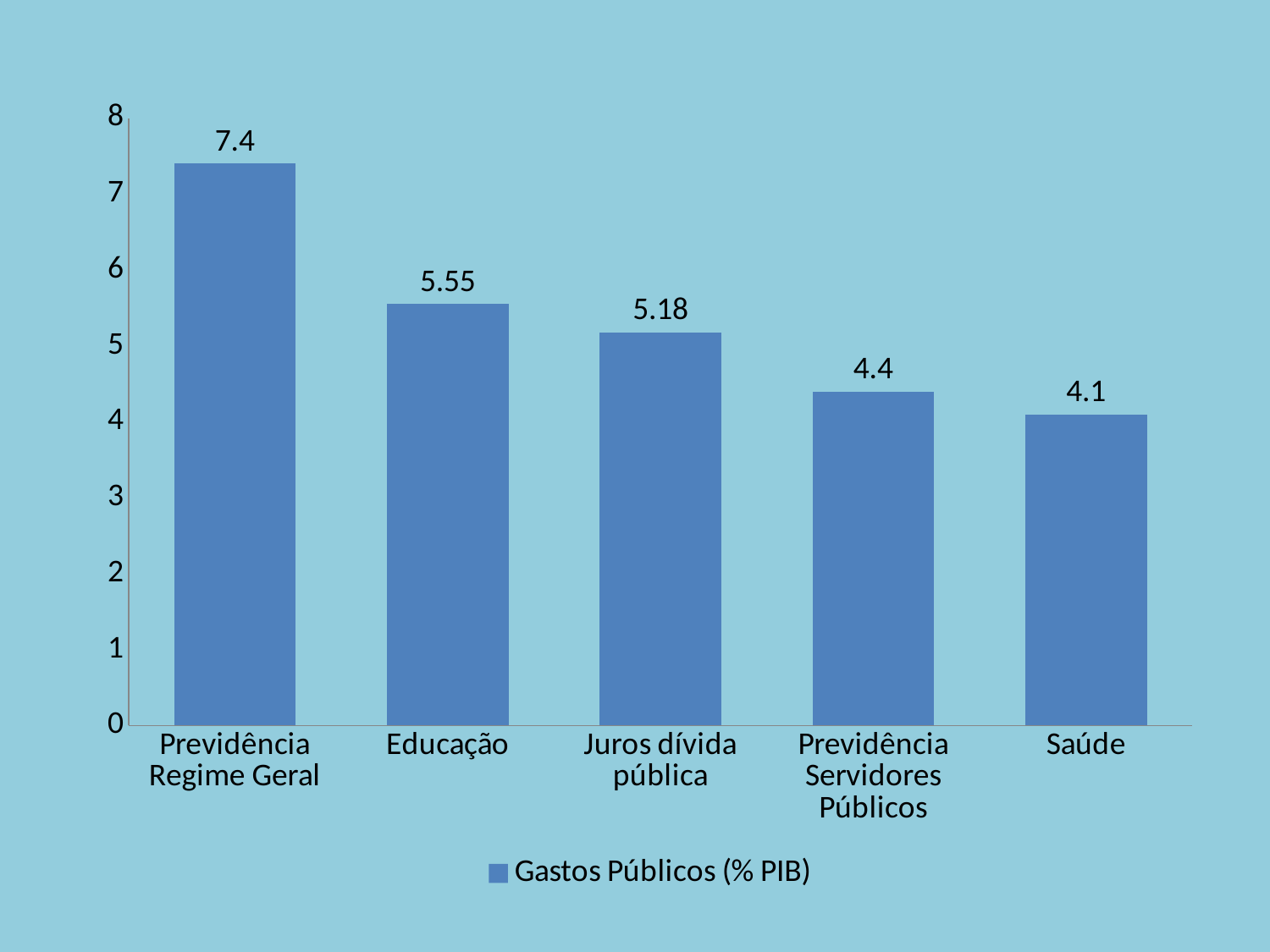
Which category has the lowest value? Saúde What series name does the legend show? Gastos Públicos (% PIB) Is the value for Previdência Servidores Públicos greater or less than 5? less Which category has the highest value? Previdência Regime Geral What is the value for Juros dívida pública? 5.18 What is the difference between the values for Previdência Regime Geral and Saúde? 3.3 How many categories are shown in the chart? 5 What is the value for Educação? 5.55 What is the value for Saúde? 4.1 What is the value for Previdência Regime Geral? 7.4 What kind of chart is shown on the slide? bar chart Which is larger, the value for Educação or the value for Juros dívida pública? Educação